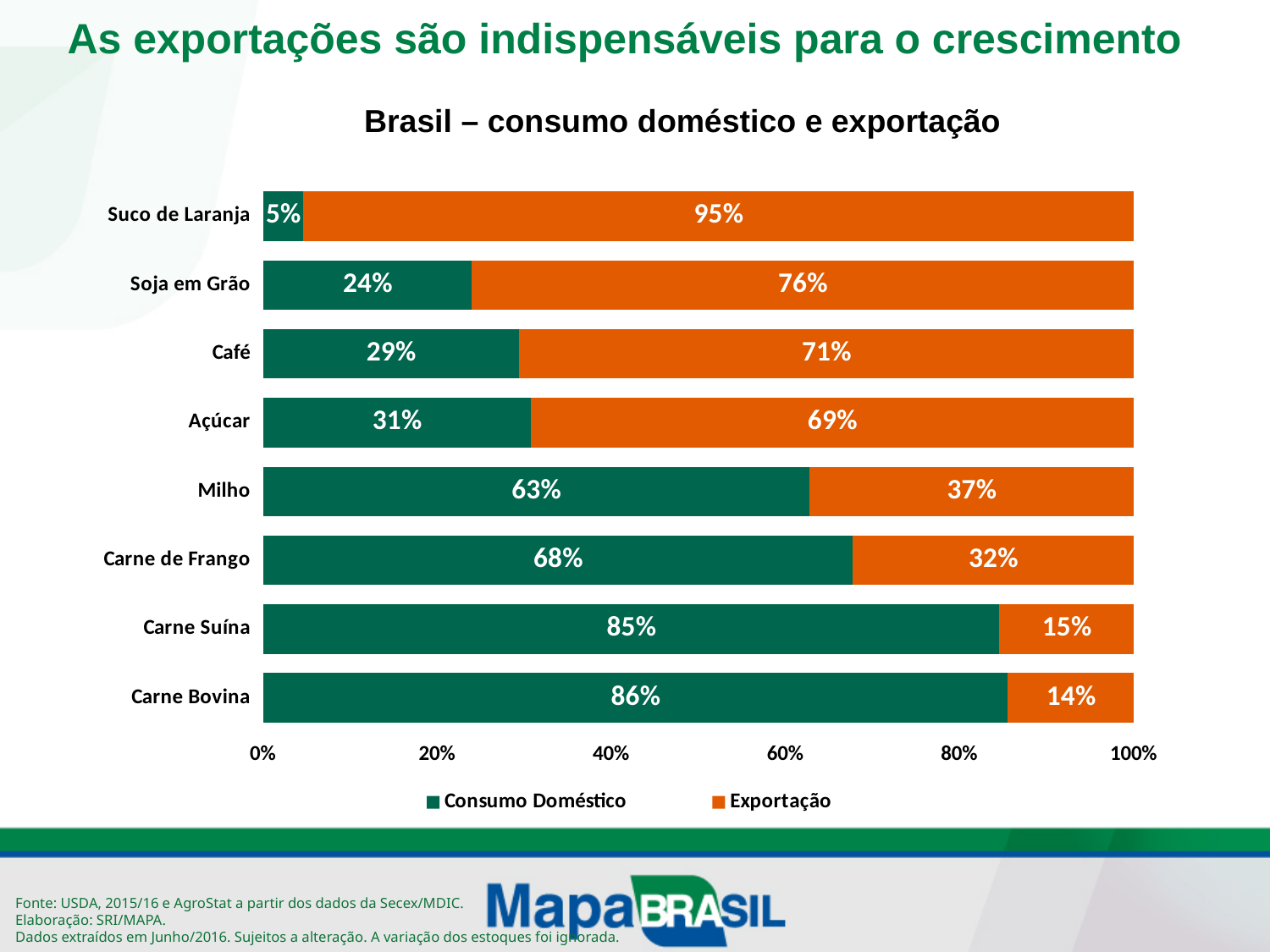
What is the Exportação value for Milho? 37% Which category has the highest Exportação share? Suco de Laranja Which category has the lowest Consumo Doméstico share? Suco de Laranja How many product categories are shown in the chart? 8 Is the Consumo Doméstico value for Açúcar greater or less than 40%? less What is the total of the stacked bar for Carne Suína? 100% What is the Exportação value for Suco de Laranja? 95% Which is larger, the Consumo Doméstico value for Milho or for Carne de Frango? Carne de Frango What is the Consumo Doméstico value for Carne Bovina? 86% What is the difference between the Exportação values for Soja em Grão and Café? 5% What kind of chart is shown on the slide? Stacked bar chart How many series does the legend list? 2